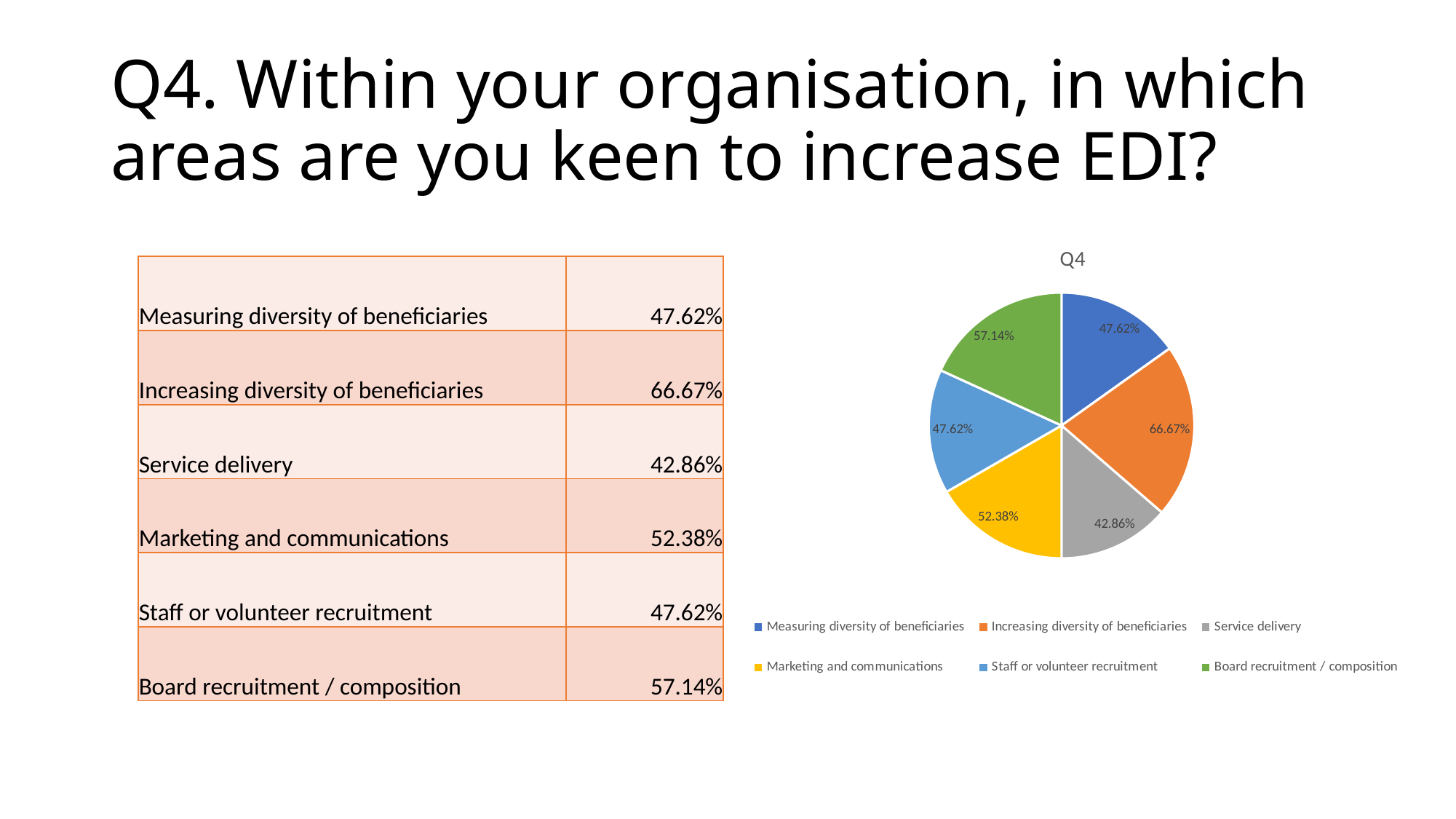
Which category has the highest value? Increasing diversity of beneficiaries Which category has the lowest value? Service delivery What value is shown for Board recruitment / composition? 57.14% What kind of chart is shown on the slide? Pie chart What is the difference between the values for Increasing diversity of beneficiaries and Service delivery? 23.81 percentage points What value is shown for Service delivery? 42.86% What value is shown for Increasing diversity of beneficiaries? 66.67% What value is shown for Marketing and communications? 52.38% How many slices does the pie chart have? 6 What colour is the Service delivery slice in the pie chart? Grey What is the title of the chart? Q4 Which is larger, the value for Board recruitment / composition or the value for Marketing and communications? Board recruitment / composition